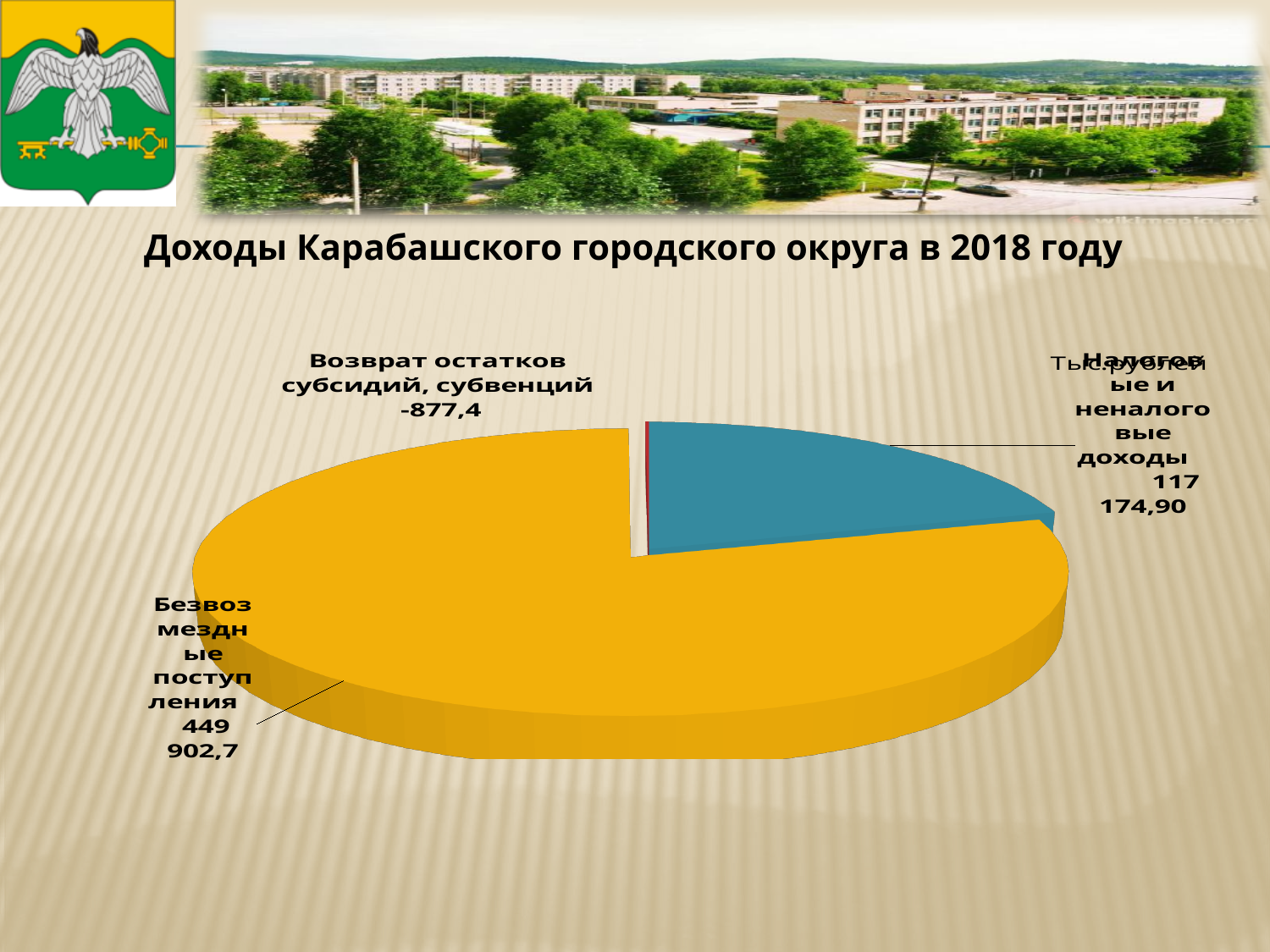
What kind of chart is shown on the slide? pie chart What is the value for Налоговые и неналоговые доходы? 117 174,90 What is the title of the chart? Доходы Карабашского городского округа в 2018 году Which is larger: Безвозмездные поступления or Налоговые и неналоговые доходы? Безвозмездные поступления In what units are the values on the chart given? Тыс.рублей What is the value for Безвозмездные поступления? 449 902,7 Which category has the smallest value? Возврат остатков субсидий, субвенций What is the value for Возврат остатков субсидий, субвенций? -877,4 How many slices does the pie chart have? 3 What is the difference between Безвозмездные поступления and Налоговые и неналоговые доходы? 332 727,8 Which category has the largest value? Безвозмездные поступления